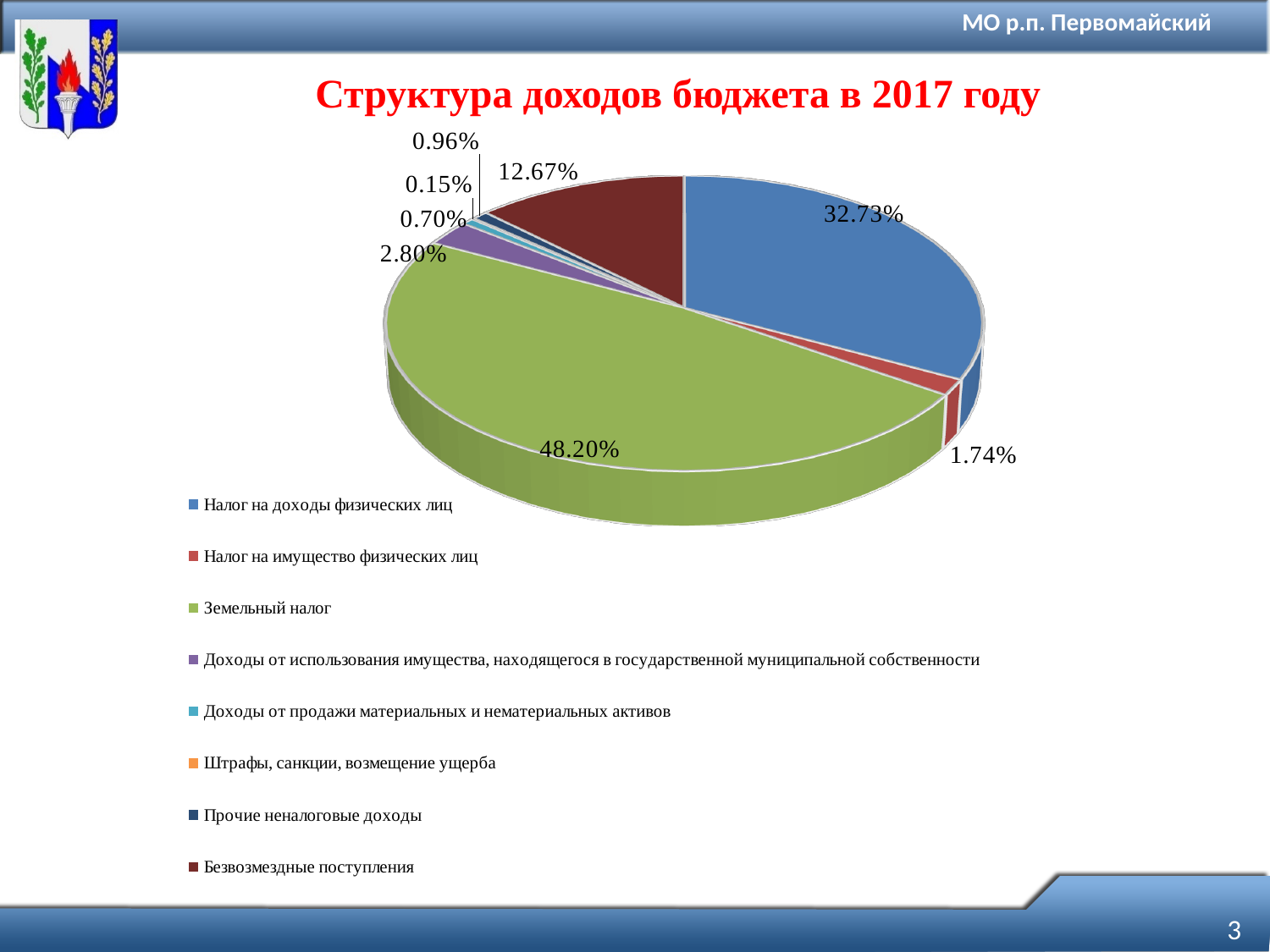
What share of the pie is Налог на доходы физических лиц? 32.73% What is the title of the chart? Структура доходов бюджета в 2017 году Which category has the largest share of the pie? Земельный налог What share of the pie is Доходы от использования имущества, находящегося в государственной муниципальной собственности? 2.80% How many categories does the legend list? 8 What share of the pie is Земельный налог? 48.20% Which category has the smallest share of the pie? Штрафы, санкции, возмещение ущерба What is the difference between the shares of Земельный налог and Налог на доходы физических лиц? 15.47% What type of chart is shown on the slide? pie chart Which is larger: the share of Безвозмездные поступления or the share of Налог на имущество физических лиц? Безвозмездные поступления